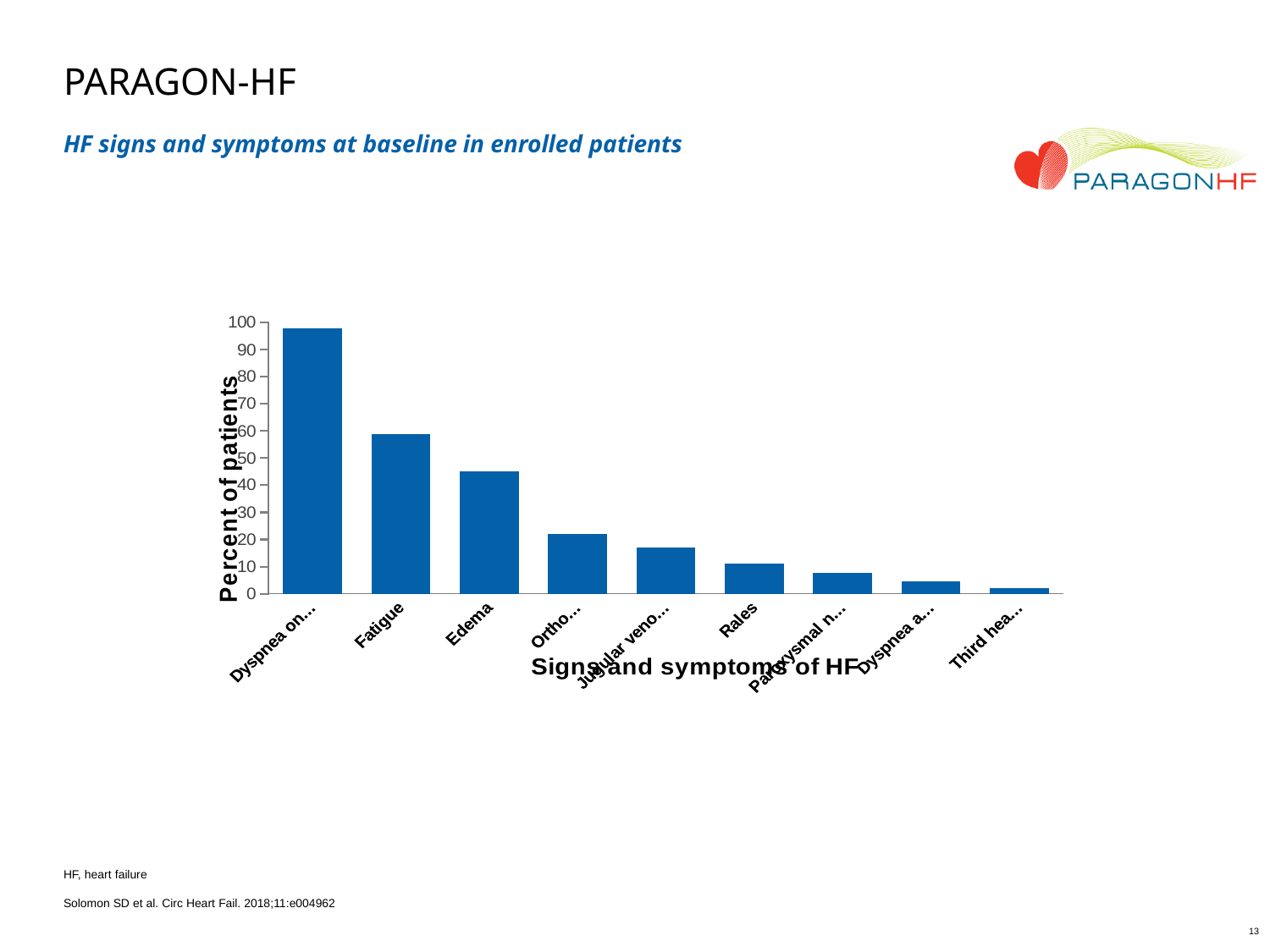
Is the value for Edema greater or less than 50? less What is the title of the horizontal axis? Signs and symptoms of HF Which has a higher percent of patients, Fatigue or Edema? Fatigue Which sign or symptom has the lowest percent of patients? Third hea... Do the bar values rise or fall from left to right along the x axis? fall Is the value for Rales greater or less than 20? less Is the value for Fatigue greater or less than 50? greater How many signs and symptoms (bars) are plotted in the chart? 9 What is the label of the vertical axis? Percent of patients Which has a higher percent of patients, Rales or Edema? Edema What kind of chart is shown on the slide? bar chart Which sign or symptom has the highest percent of patients? Dyspnea on...